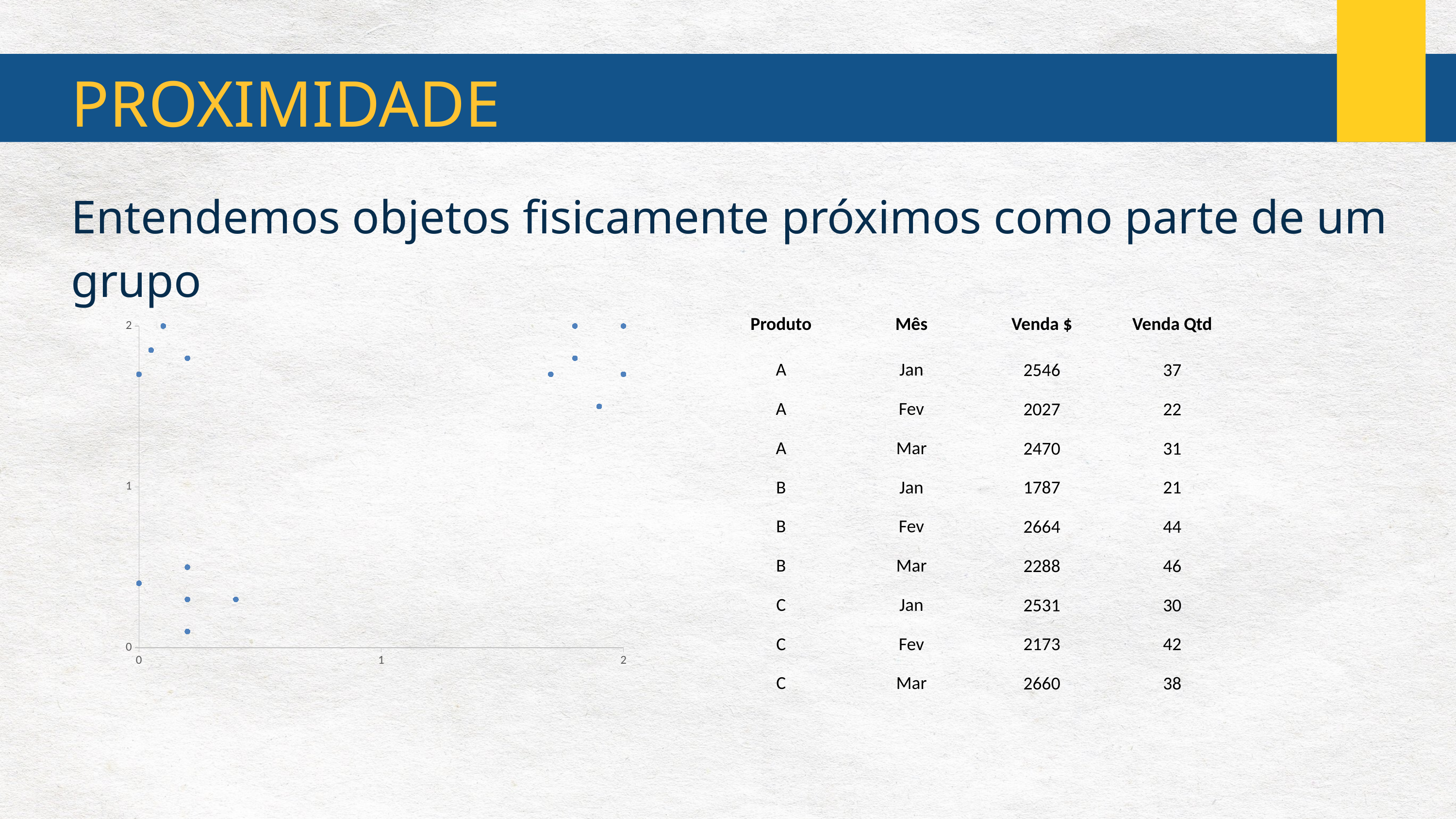
How many distinct clusters of points does the scatter chart show? 3 Are the points in the lower-left cluster of the scatter chart greater or less than 1 on the y axis? less What is the highest value shown on the y axis of the scatter chart? 2 How many points in the scatter chart have an x value greater than 1? 6 Are the points in the upper-right cluster of the scatter chart above or below 1 on the y axis? above What is the highest value shown on the x axis of the scatter chart? 2 What colour are the points in the scatter chart? blue What kind of chart is shown on the left of the slide? scatter chart